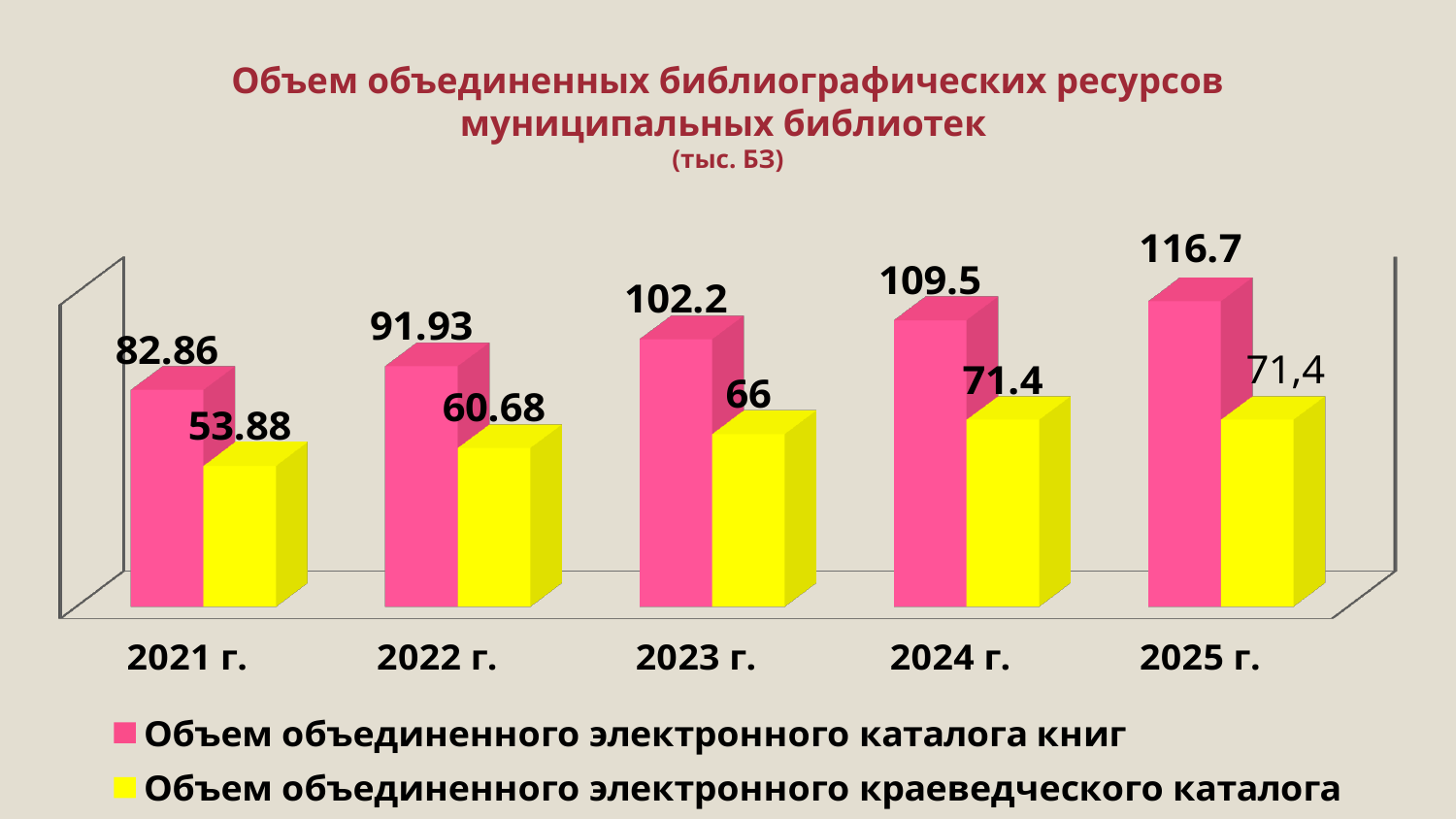
What unit is given under the chart title? тыс. БЗ In which year is Объем объединенного электронного краеведческого каталога lowest? 2021 г. What is the value for Объем объединенного электронного краеведческого каталога in 2022 г.? 60.68 What is the value for Объем объединенного электронного каталога книг in 2021 г.? 82.86 What kind of chart is shown on the slide? bar chart What is the value for Объем объединенного электронного каталога книг in 2023 г.? 102.2 Does Объем объединенного электронного каталога книг rise or fall from 2021 г. to 2025 г.? rise How many series does the legend list? 2 What is the difference between Объем объединенного электронного каталога книг and Объем объединенного электронного краеведческого каталога in 2024 г.? 38.1 How many years are shown on the x axis? 5 In which year is Объем объединенного электронного каталога книг highest? 2025 г. Which is larger: Объем объединенного электронного каталога книг in 2022 г. or in 2023 г.? 2023 г.